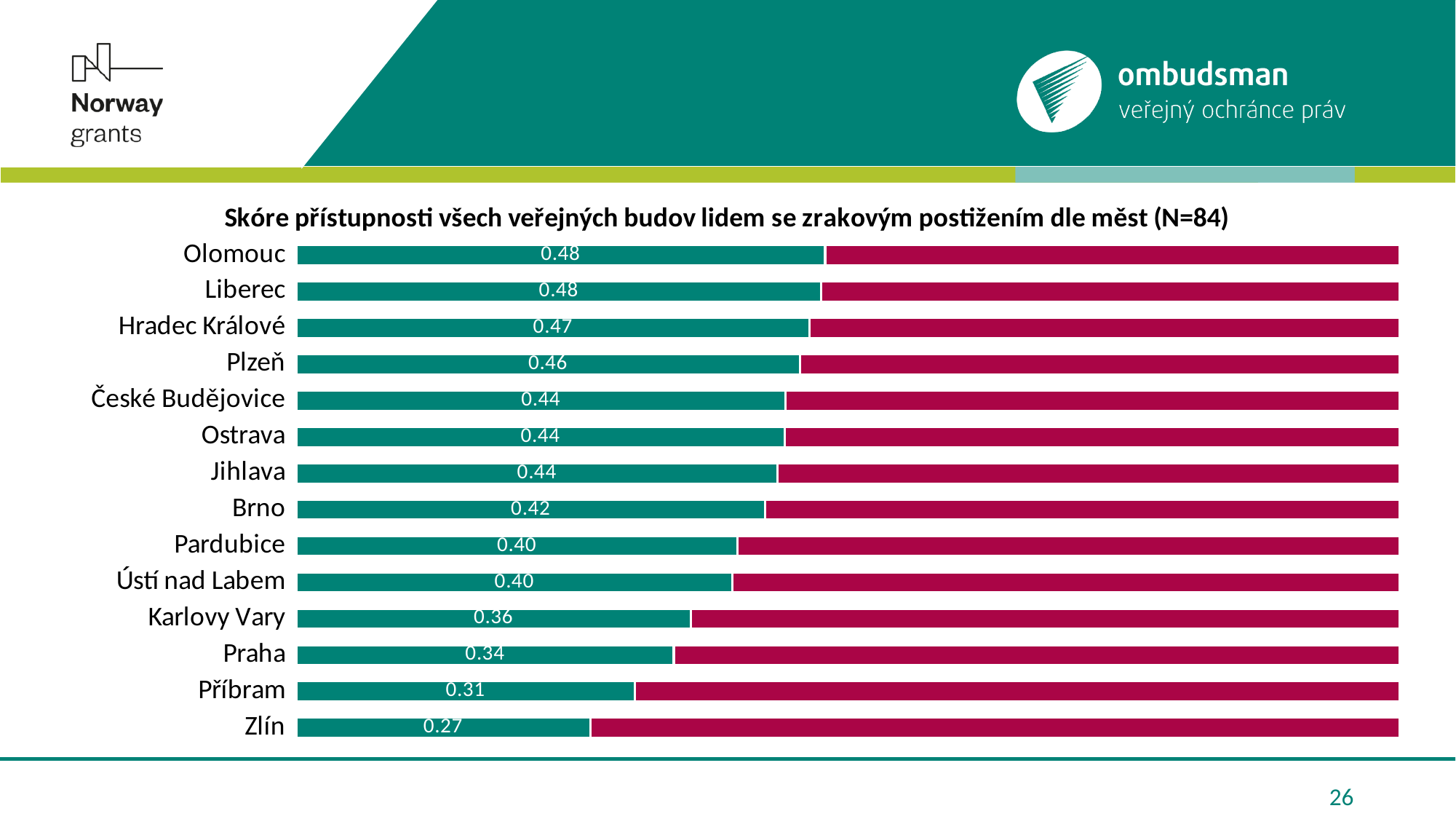
What is the accessibility score shown for Karlovy Vary? 0.36 What is the accessibility score shown for Brno? 0.42 What is the accessibility score shown for Olomouc? 0.48 Which city has a higher score, Příbram or Karlovy Vary? Karlovy Vary What is the difference between the scores of Brno and Praha? 0.08 What type of chart is shown on the slide? Bar chart What is the highest accessibility score shown in the chart? 0.48 What is the difference between the scores of Olomouc and Zlín? 0.21 What is the accessibility score shown for Praha? 0.34 How many cities are shown in the chart? 14 Which city has a higher score, Praha or Brno? Brno Which city has the lowest accessibility score in the chart? Zlín